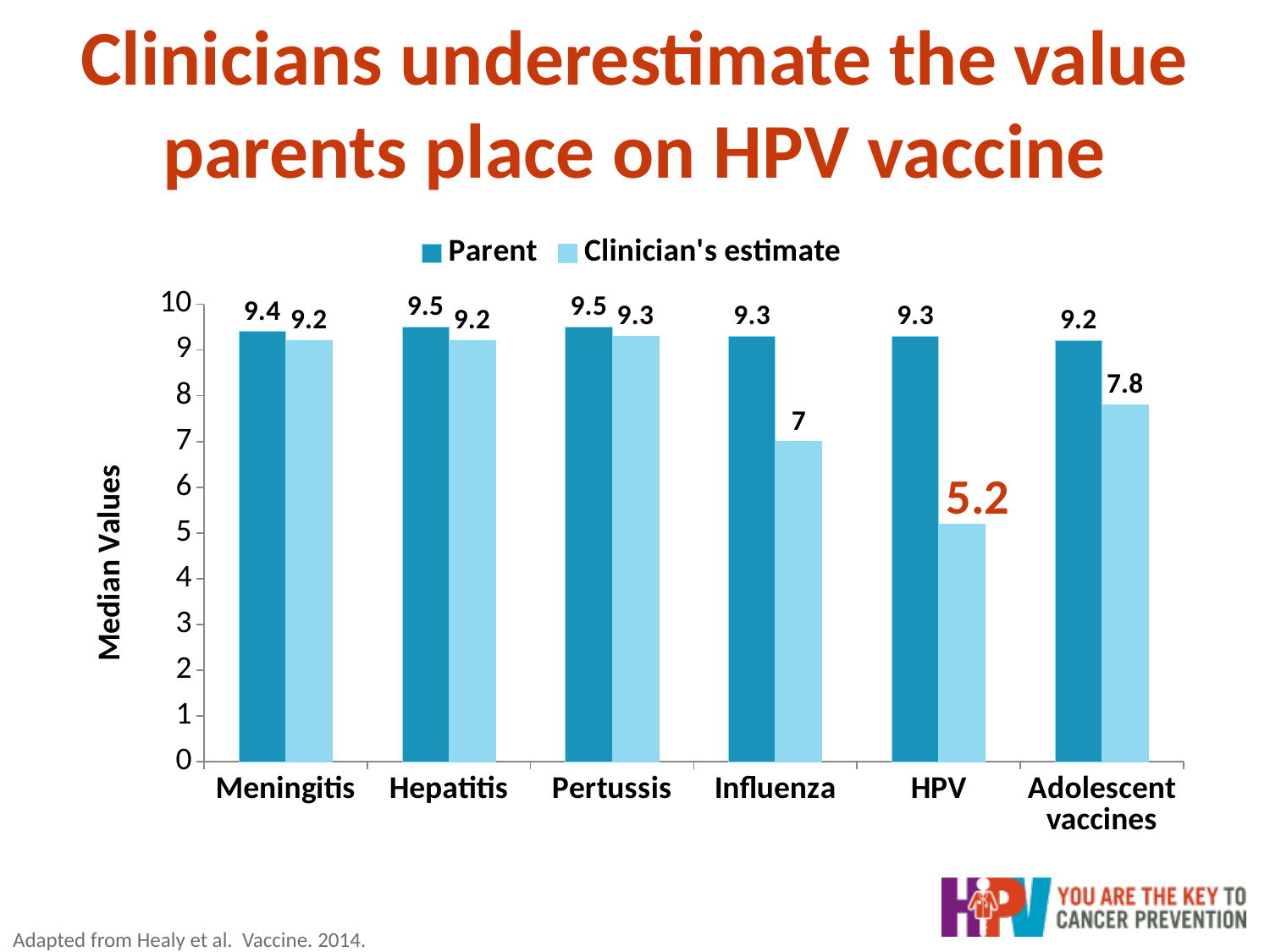
What is the Parent median value for HPV? 9.3 How many series does the legend list? 2 What is the label of the y axis? Median Values What is the Clinician's estimate for HPV? 5.2 Which category has the lowest Clinician's estimate? HPV How many vaccine categories are shown on the x axis? 6 What kind of chart is shown on the slide? Bar chart What is the Parent median value for Adolescent vaccines? 9.2 What is the difference between the Parent value and the Clinician's estimate for Influenza? 2.3 What is the difference between the Parent value and the Clinician's estimate for HPV? 4.1 What is the Clinician's estimate for Influenza? 7 Which is larger for Adolescent vaccines, the Parent value or the Clinician's estimate? Parent